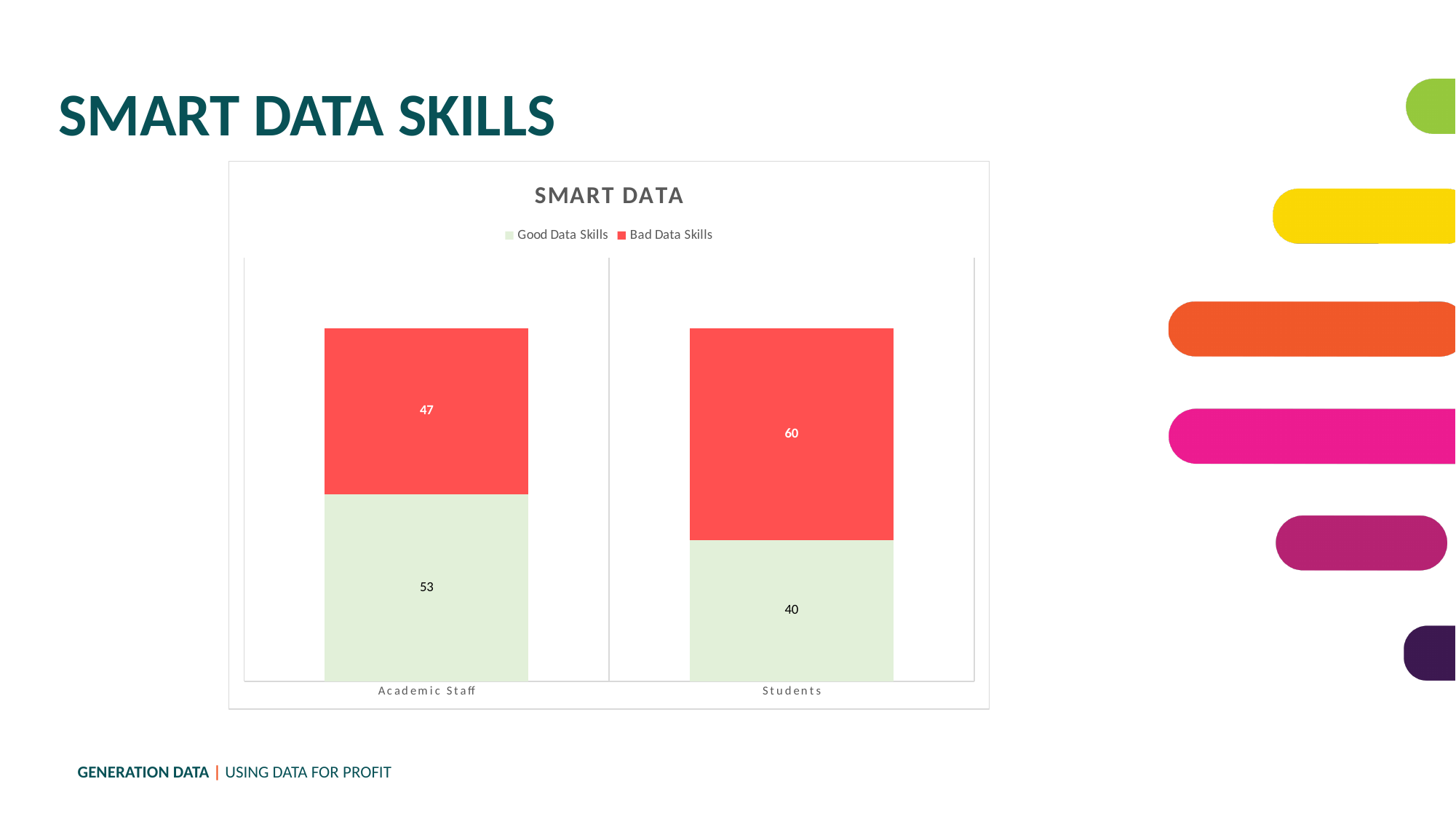
What is the value for Good Data Skills for Students? 40 What is the value for Bad Data Skills for Students? 60 What is the total of the stacked bar for Students? 100 What is the value for Good Data Skills for Academic Staff? 53 Which category has the higher Good Data Skills value? Academic Staff Which category has the lower Bad Data Skills value? Academic Staff What is the difference between the Bad Data Skills values for Students and Academic Staff? 13 What is the value for Bad Data Skills for Academic Staff? 47 How many categories are shown on the x axis? 2 What kind of chart is shown? Stacked bar chart Which is larger: Good Data Skills for Academic Staff or Good Data Skills for Students? Academic Staff How many series does the legend list? 2